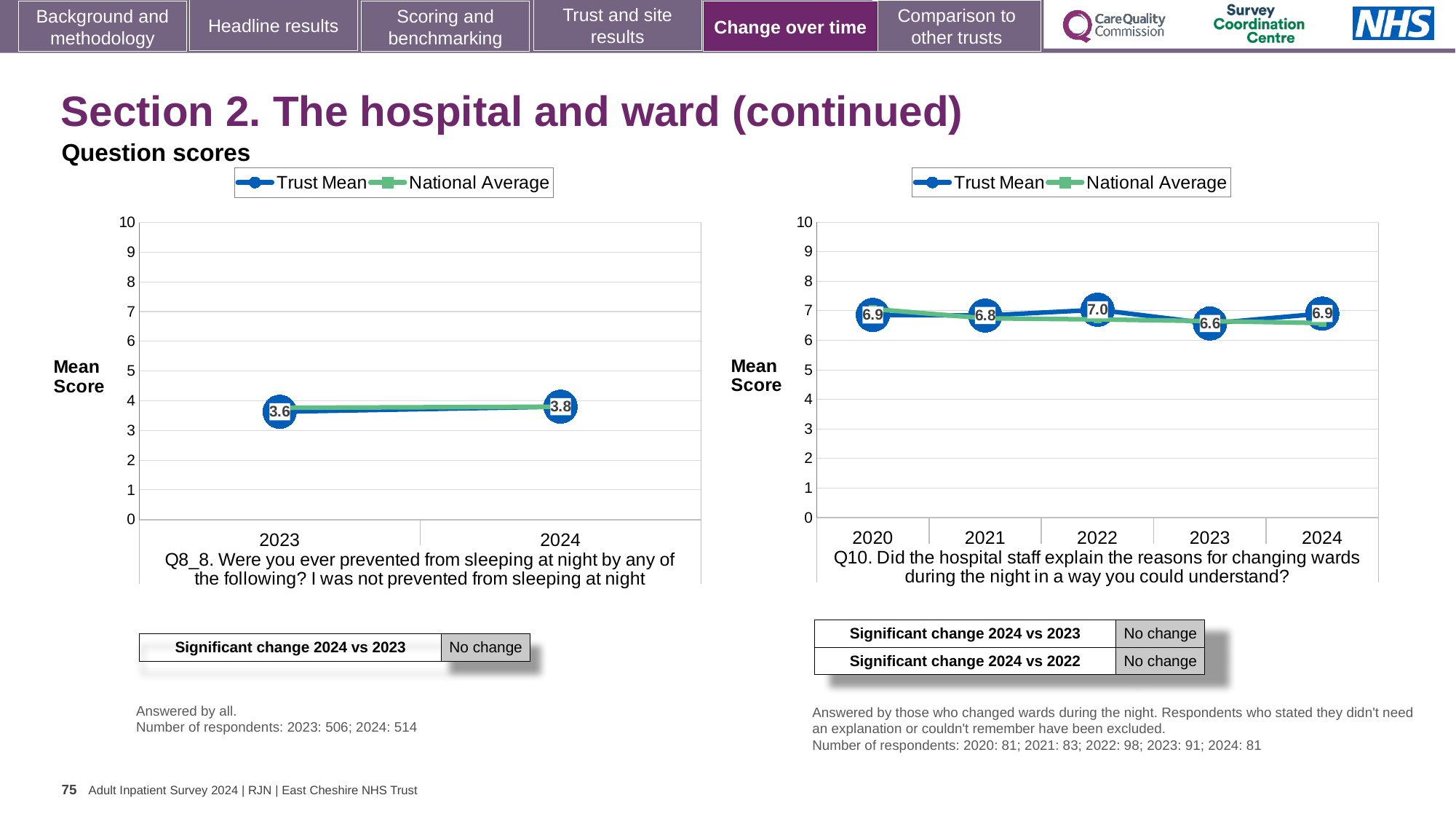
In the right chart (Q10), what is the Trust Mean score for 2023? 6.6 In the right chart (Q10), which year has the highest Trust Mean score? 2022 How many series does the legend of the left chart (Q8_8) list? 2 In the left chart (Q8_8), what is the Trust Mean score for 2024? 3.8 What type of chart is the right chart (Q10)? Line chart In the right chart (Q10), which year has the lowest Trust Mean score? 2023 In the left chart (Q8_8), does the Trust Mean rise or fall from 2023 to 2024? Rise In the right chart (Q10), is the Trust Mean score for 2020 greater or less than 5? greater In the left chart (Q8_8), what is the Trust Mean score for 2023? 3.6 In the left chart (Q8_8), what is the difference between the Trust Mean scores for 2024 and 2023? 0.2 How many years are plotted on the x axis of the right chart (Q10)? 5 In the right chart (Q10), what is the Trust Mean score for 2022? 7.0